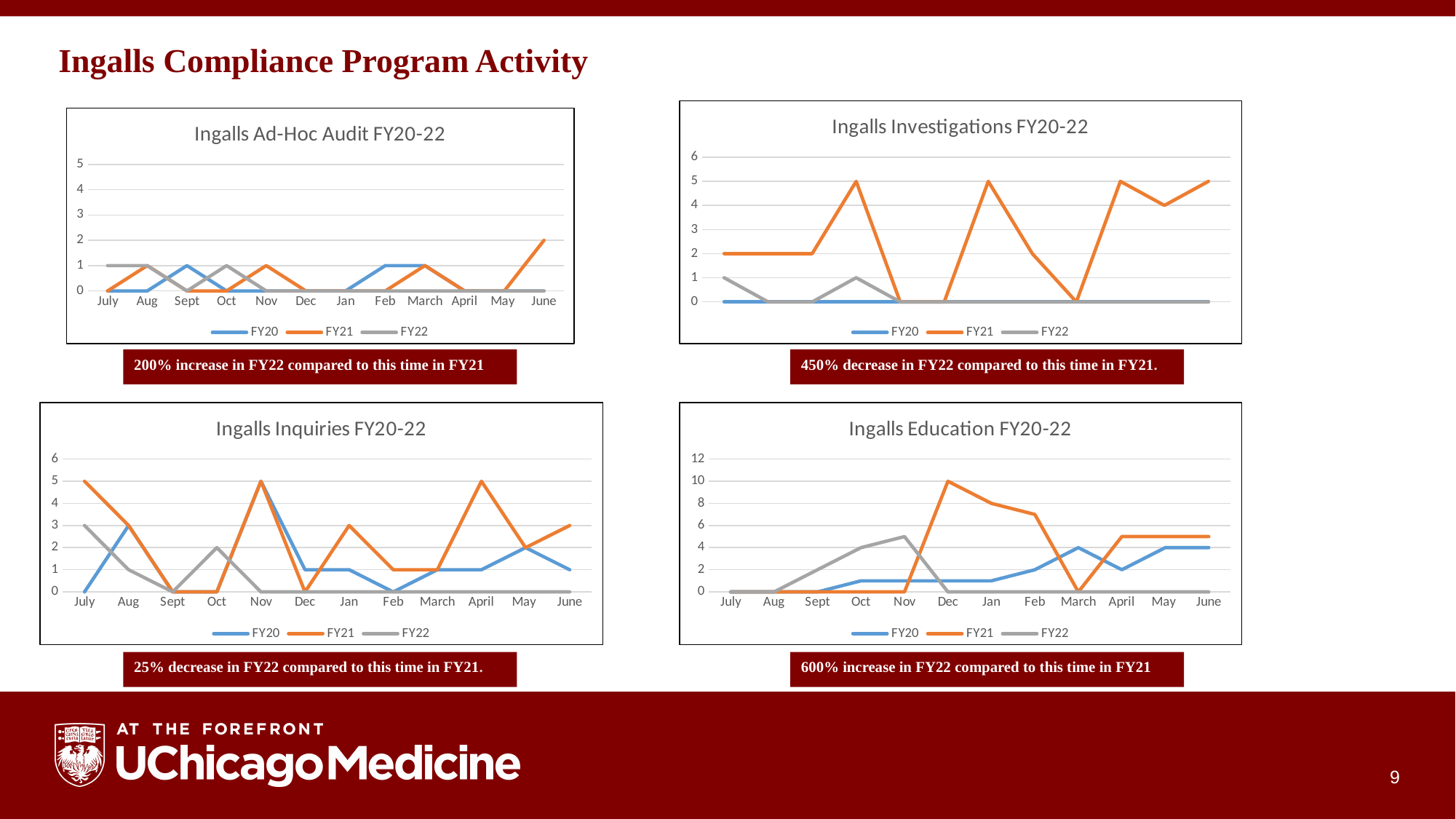
In the Ingalls Inquiries FY20-22 chart, which is larger for July: the FY21 value or the FY22 value? FY21 In the Ingalls Education FY20-22 chart, what is the FY21 value for Dec? 10 In the Ingalls Education FY20-22 chart, is the FY21 value for Feb greater or less than 6? greater In the Ingalls Education FY20-22 chart, what is the difference between the FY21 values for Dec and Jan? 2 In the Ingalls Ad-Hoc Audit FY20-22 chart, what is the FY21 value for June? 2 In the Ingalls Education FY20-22 chart, which month has the highest FY21 value? Dec How many series does the legend of the Ingalls Investigations FY20-22 chart list? 3 In the Ingalls Investigations FY20-22 chart, what is the FY21 value for May? 4 What does the caption below the Ingalls Education FY20-22 chart say? 600% increase in FY22 compared to this time in FY21 What kind of chart is the Ingalls Ad-Hoc Audit FY20-22 chart? line chart How many months are shown on the x axis of the Ingalls Inquiries FY20-22 chart? 12 In the Ingalls Education FY20-22 chart, does the FY21 line rise or fall from Dec to March? fall